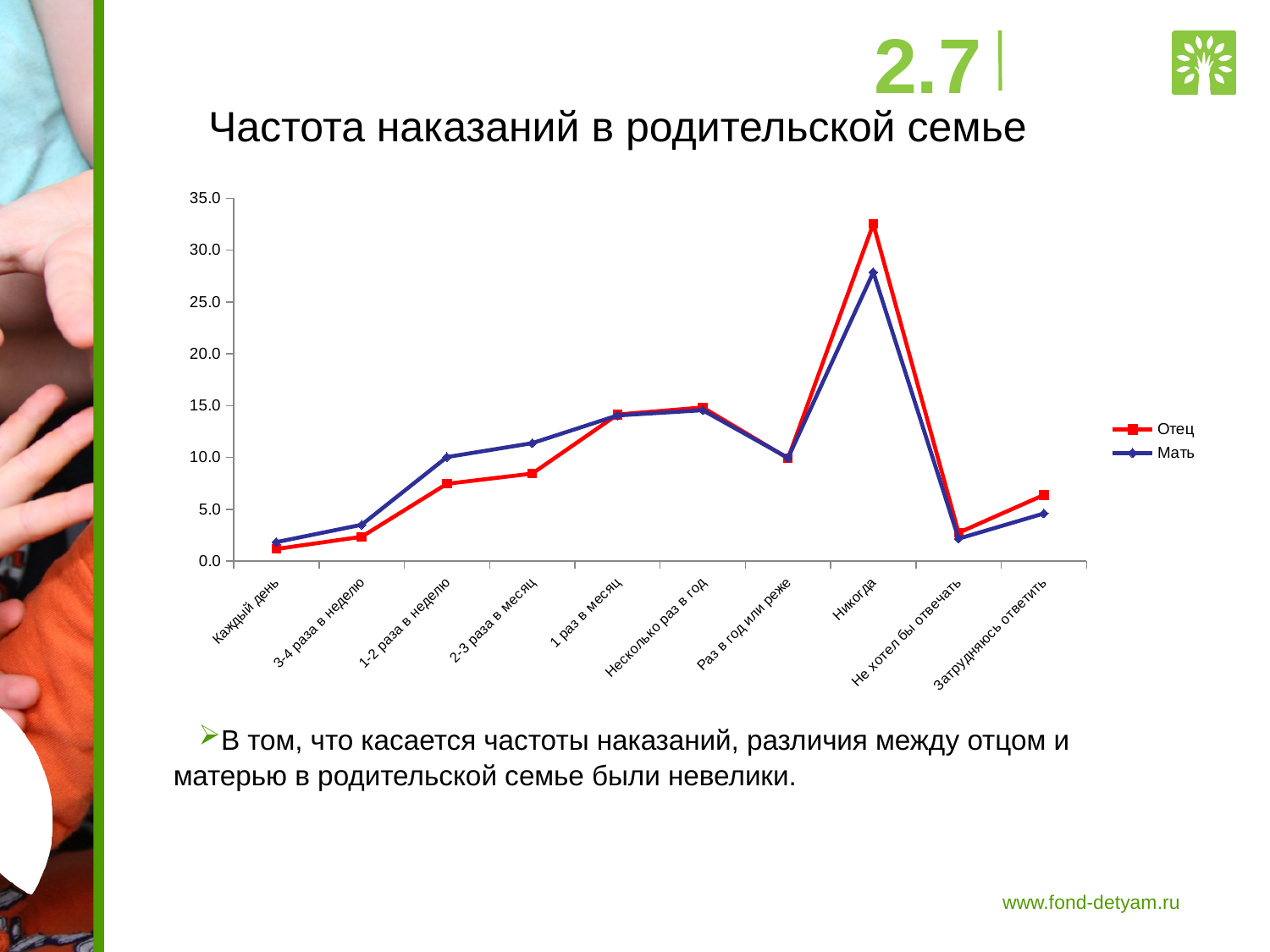
Is the value for Мать at Никогда greater or less than 30.0? less How many categories are shown on the x axis? 10 Is the value for Мать at 2-3 раза в месяц greater or less than 10.0? greater How many series does the legend list? 2 Is the value for Отец at 1-2 раза в неделю greater or less than 10.0? less At Никогда, which series has the larger value, Отец or Мать? Отец What kind of chart is shown on the slide? line chart For which category is the value for Мать highest? Никогда For which category is the value for Отец highest? Никогда At 1-2 раза в неделю, which series has the larger value, Отец or Мать? Мать For which category is the value for Отец lowest? Каждый день